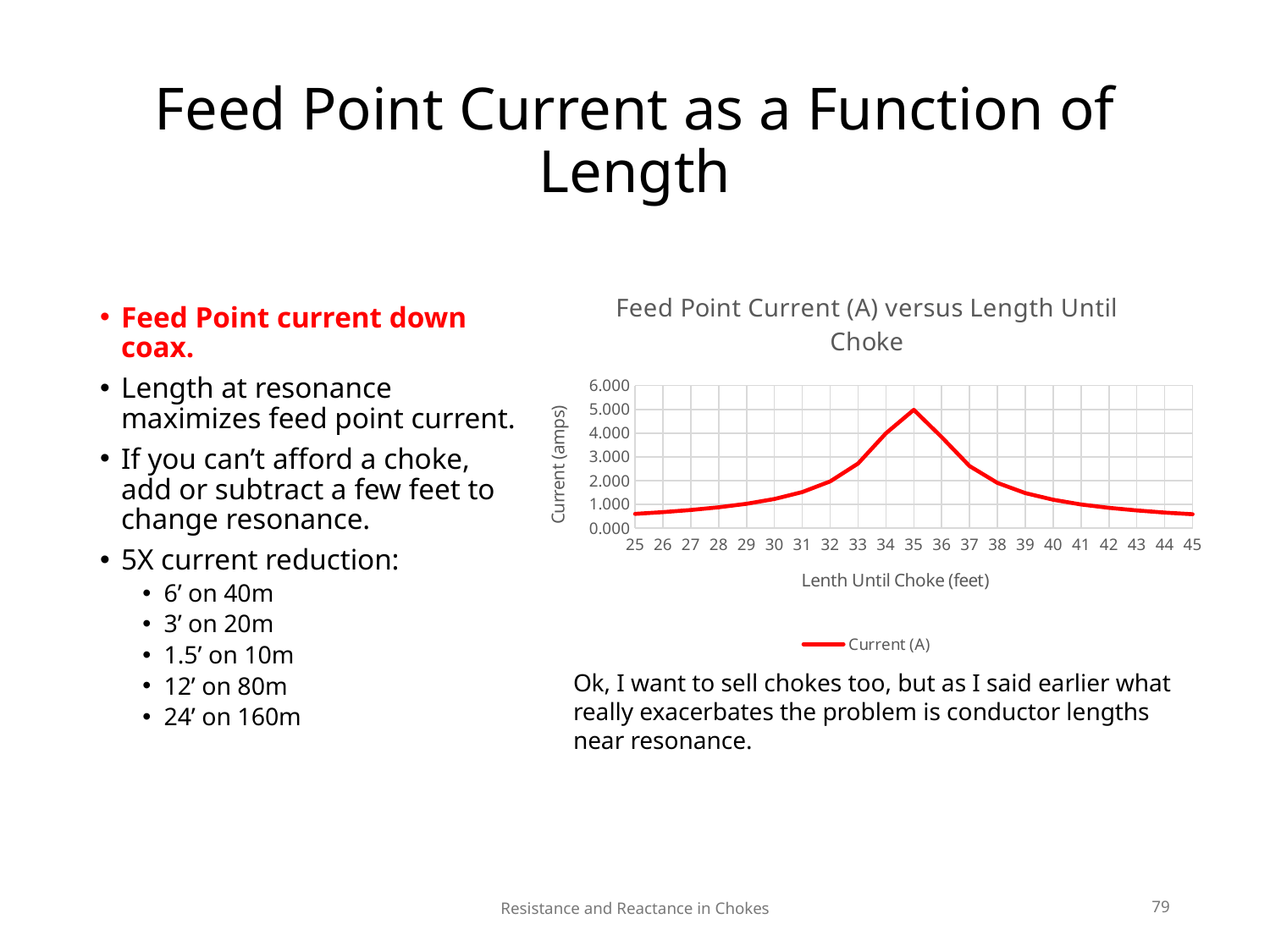
Is the current at a length of 37 feet greater or less than 3.000? less What is the title of the chart? Feed Point Current (A) versus Length Until Choke Is the current at a length of 25 feet greater or less than 1.000? less How many series does the legend list? 1 Does the current rise or fall as the length increases from 35 feet to 45 feet? fall Is the current at a length of 35 feet greater or less than 4.000? greater How many length values are plotted along the x axis? 21 Which length has the higher current, 33 feet or 38 feet? 33 feet At which length until choke (feet) is the feed point current highest? 35 What kind of chart is shown on the slide? line chart